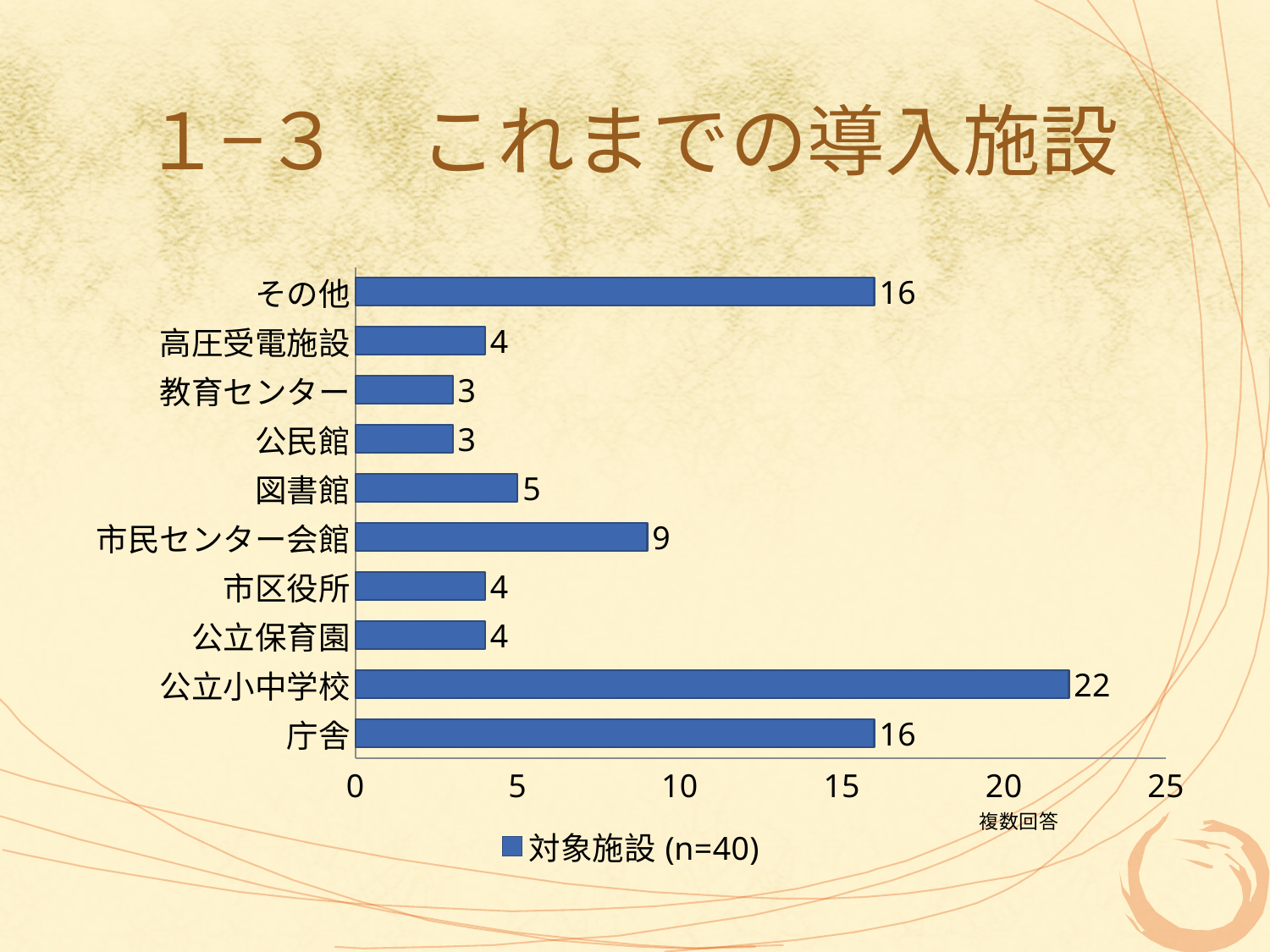
Is the value for 公立小中学校 greater or less than 20? greater What is the legend entry for the series? 対象施設 (n=40) What is the value for 市民センター会館? 9 What kind of chart is shown on the slide? bar chart Which is larger, the value for 市民センター会館 or the value for 高圧受電施設? 市民センター会館 What is the value for 図書館? 5 How many categories are shown in the chart? 10 What is the value for 公立小中学校? 22 Which category has the highest value? 公立小中学校 What is the difference between the values for その他 and 市民センター会館? 7 How many series does the legend list? 1 What is the difference between the values for 公立小中学校 and 庁舎? 6